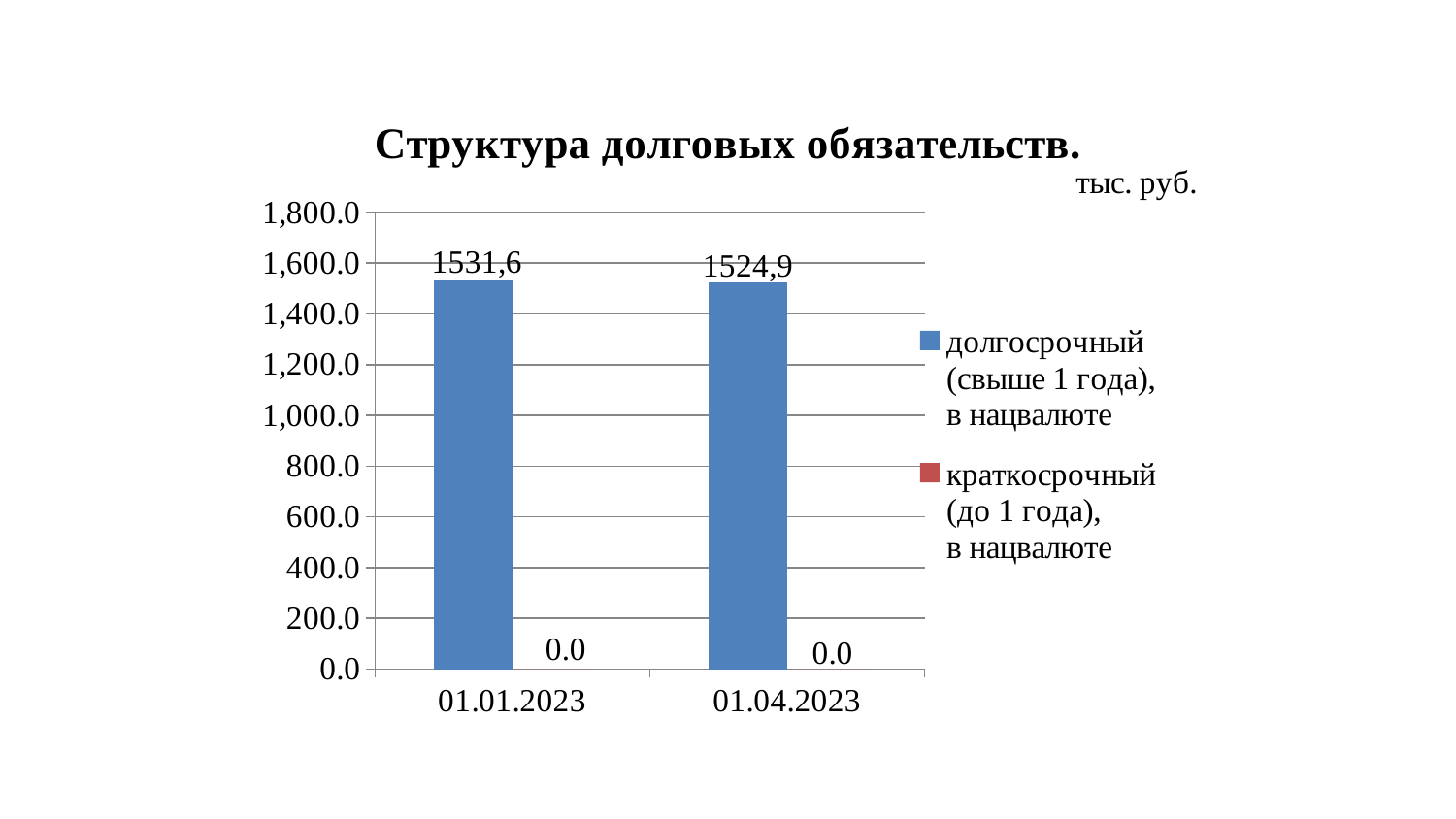
What is the title of the chart? Структура долговых обязательств. On which date is the долгосрочный (свыше 1 года), в нацвалюте value highest? 01.01.2023 What is the value of краткосрочный (до 1 года), в нацвалюте on 01.01.2023? 0.0 What unit is indicated for the values in the chart? тыс. руб. How many series does the legend list? 2 What is the value of краткосрочный (до 1 года), в нацвалюте on 01.04.2023? 0.0 What is the difference between the долгосрочный values on 01.01.2023 and 01.04.2023? 6,7 How many categories (dates) are shown on the x axis? 2 What is the value of долгосрочный (свыше 1 года), в нацвалюте on 01.04.2023? 1524,9 Does the долгосрочный (свыше 1 года), в нацвалюте value rise or fall from 01.01.2023 to 01.04.2023? fall What is the value of долгосрочный (свыше 1 года), в нацвалюте on 01.01.2023? 1531,6 What type of chart is shown on the slide? bar chart